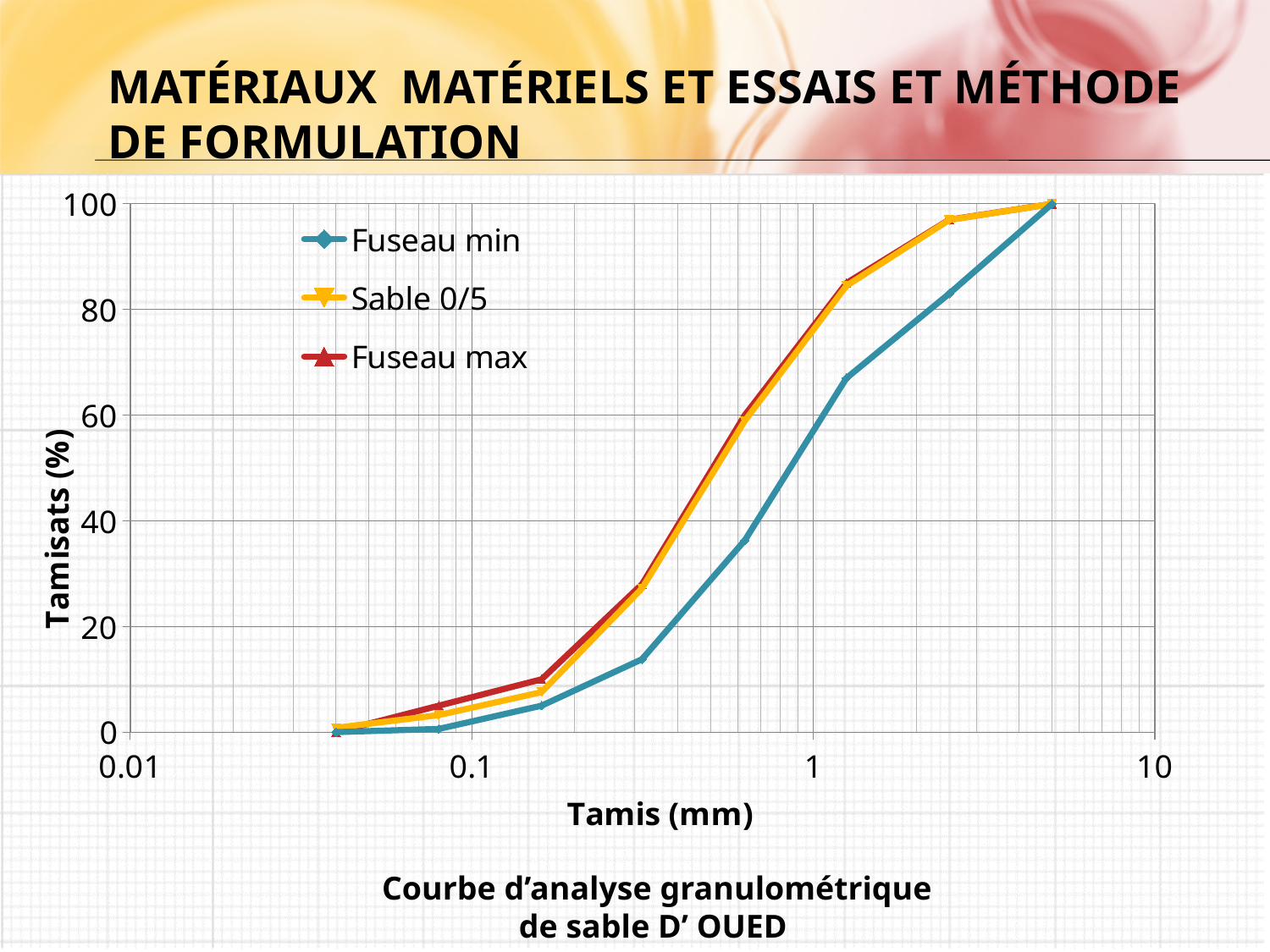
Is the value of Sable 0/5 at about 1.25 mm greater or less than 80? greater Is the value of Fuseau min at about 0.3 mm greater or less than 20? less Which series has the lowest values across the middle of the chart (around 0.3 to 2 mm)? Fuseau min How many series does the legend list? 3 At about 0.63 mm, which series has the larger value, Fuseau max or Fuseau min? Fuseau max Is the value of Fuseau min at about 1.25 mm greater or less than 60? greater What value do all three series reach at the largest sieve size plotted? 100 What is the title of the y axis? Tamisats (%) Which series are listed in the legend? Fuseau min, Sable 0/5, Fuseau max What kind of chart is shown on the slide? Line chart Do the values of the Sable 0/5 series rise or fall as the sieve size (Tamis) increases? Rise